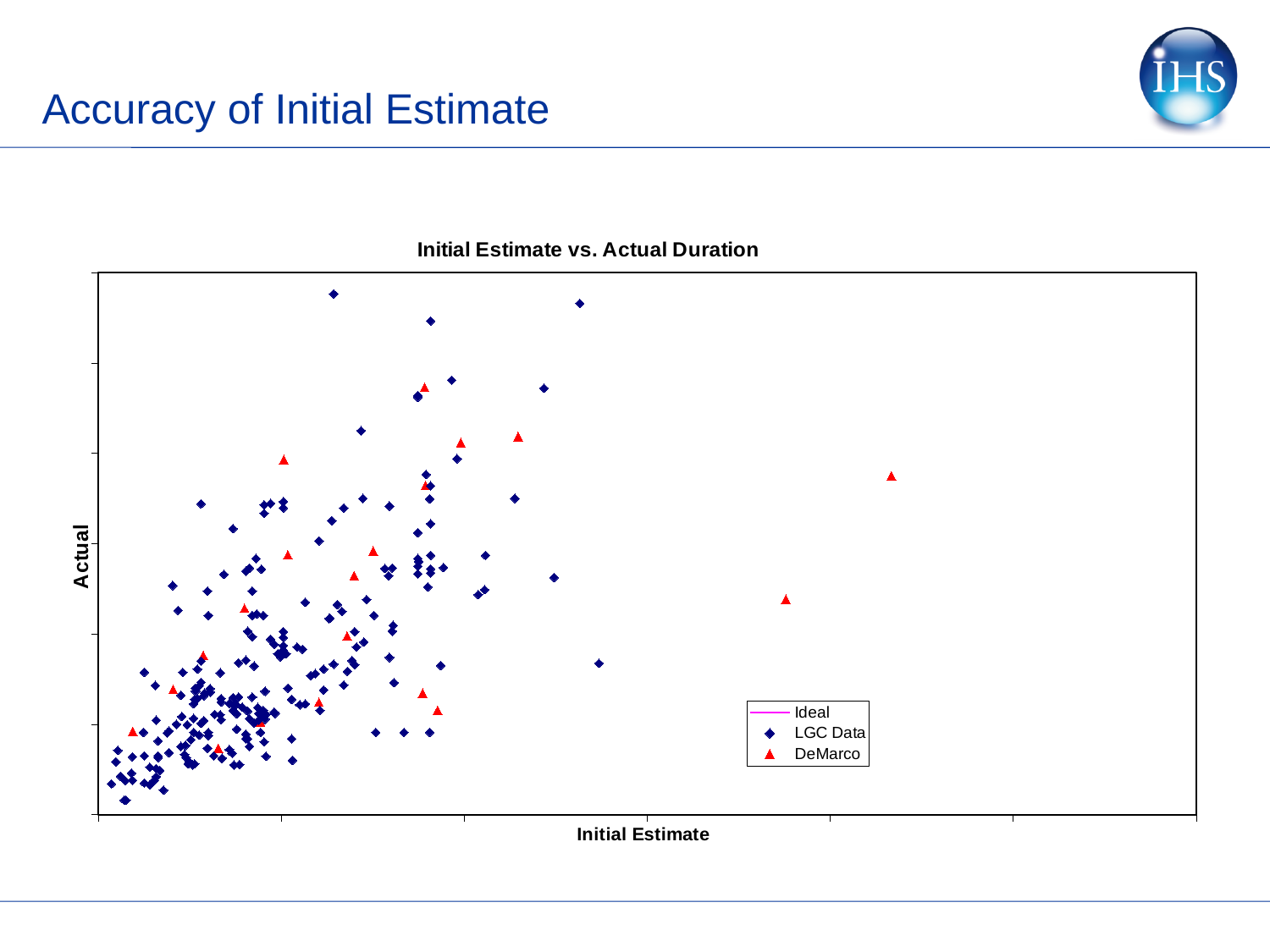
Which series contains the point with the largest Initial Estimate (the point furthest to the right)? DeMarco What kind of chart is shown on the slide? scatter chart What is the label on the x axis of the chart? Initial Estimate How many series does the legend list? 3 Which series has more plotted points, LGC Data or DeMarco? LGC Data Do the Actual values generally rise or fall as the Initial Estimate increases along the x axis? rise Which series contains the point with the highest Actual value (the point nearest the top)? LGC Data What is the title of the chart? Initial Estimate vs. Actual Duration